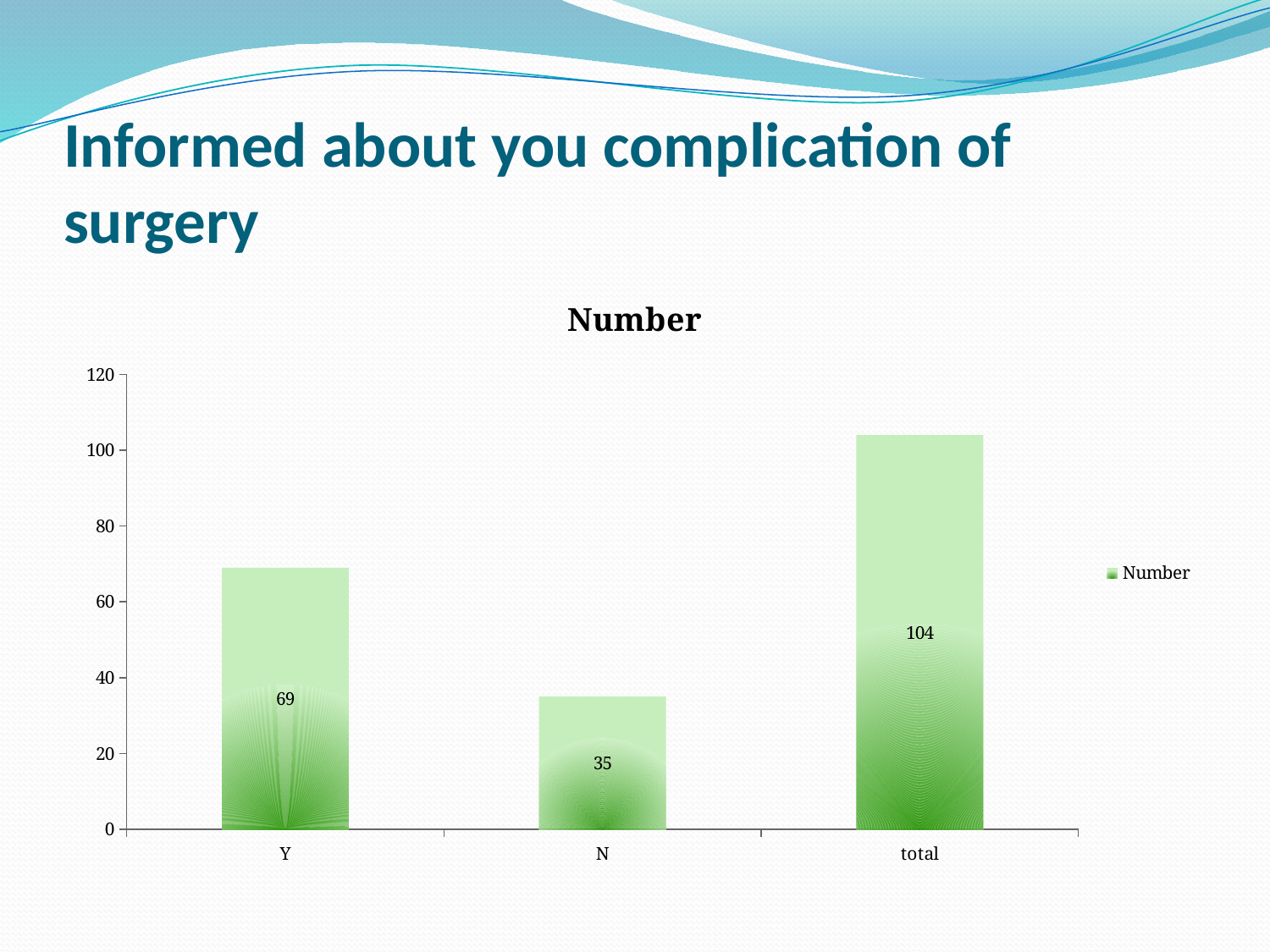
What is the value for Y? 69 What is the value for N? 35 Which category has the highest value? total What kind of chart is shown? bar chart What is the title of the chart? Number Is the value for total greater or less than 100? greater What is the value for total? 104 Which category has the lowest value? N What is the difference between the values for Y and N? 34 How many series does the legend list? 1 How many categories are shown on the x axis? 3 Which is larger, the value for Y or the value for N? Y